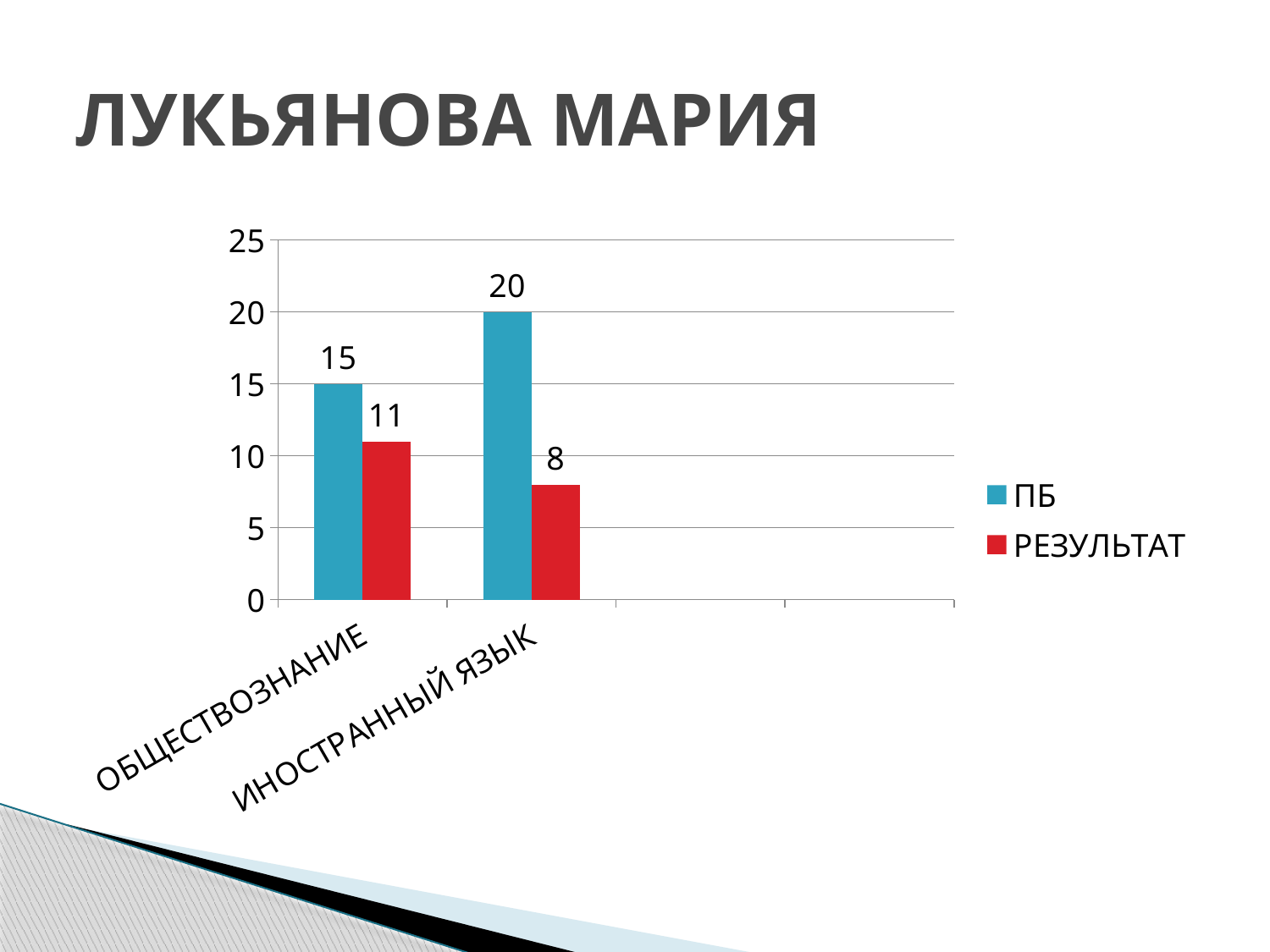
Which is larger for ОБЩЕСТВОЗНАНИЕ, the ПБ value or the РЕЗУЛЬТАТ value? ПБ Which category has the lowest РЕЗУЛЬТАТ value? ИНОСТРАННЫЙ ЯЗЫК What is the difference between the ПБ and РЕЗУЛЬТАТ values for ИНОСТРАННЫЙ ЯЗЫК? 12 What is the ПБ value for ОБЩЕСТВОЗНАНИЕ? 15 What is the ПБ value for ИНОСТРАННЫЙ ЯЗЫК? 20 What is the difference between the ПБ and РЕЗУЛЬТАТ values for ОБЩЕСТВОЗНАНИЕ? 4 How many categories are shown on the x axis? 2 What kind of chart is shown on the slide? Bar chart What is the РЕЗУЛЬТАТ value for ОБЩЕСТВОЗНАНИЕ? 11 Which category has the highest ПБ value? ИНОСТРАННЫЙ ЯЗЫК How many series does the legend list? 2 What is the РЕЗУЛЬТАТ value for ИНОСТРАННЫЙ ЯЗЫК? 8